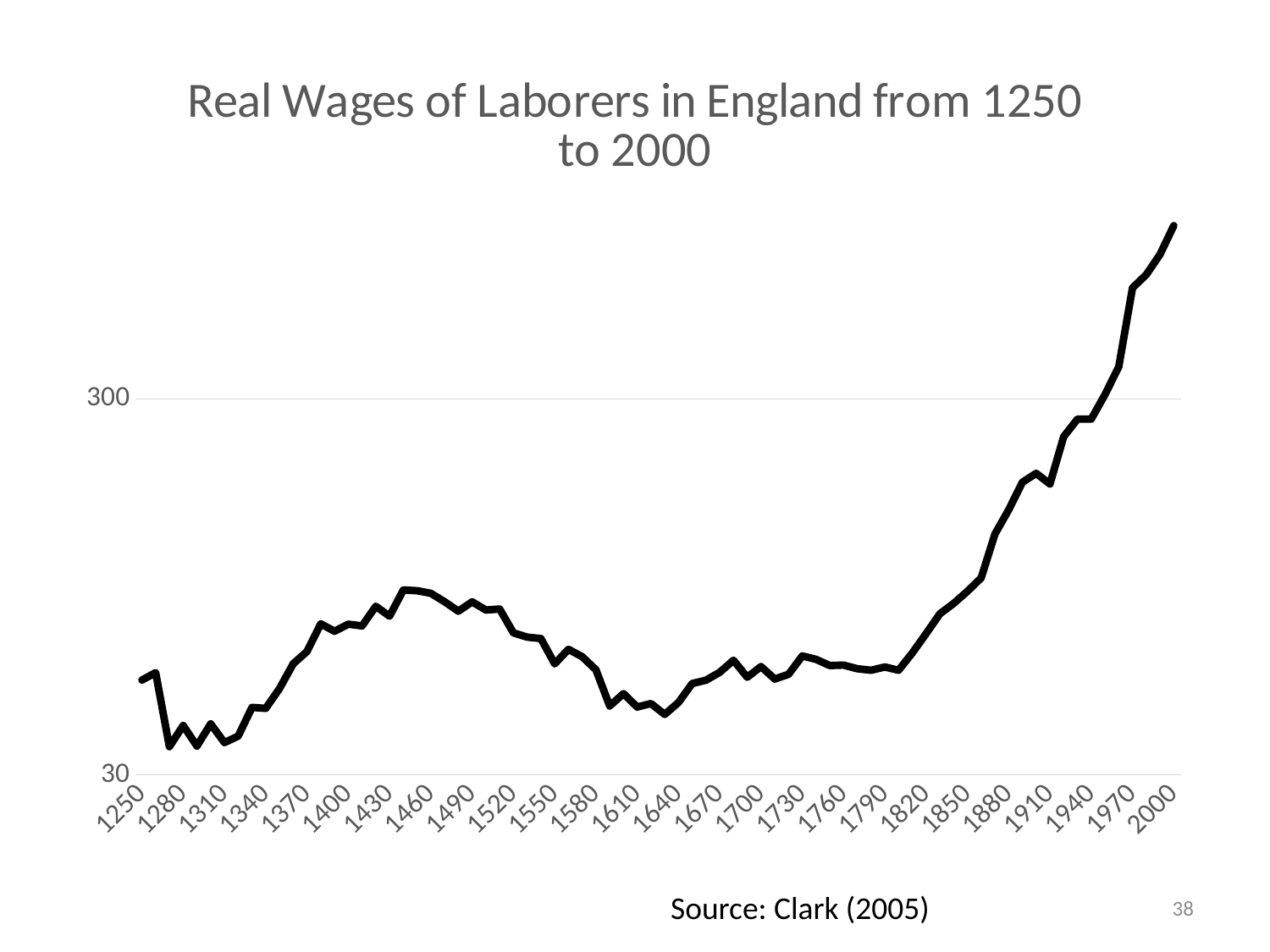
Is the value for 1970 greater or less than 300? greater What kind of chart is shown on the slide? line chart Do real wages rise or fall between 1820 and 2000? rise How many year labels are shown on the x axis? 26 Is the value for 1910 greater or less than 300? less Which year has the higher real wage, 1250 or 2000? 2000 In which year shown on the x axis is the real wage highest? 2000 Which year has the higher real wage, 1460 or 1610? 1460 Is the value for 1460 greater or less than 300? less What source is cited for the chart? Clark (2005) What is the title of the chart? Real Wages of Laborers in England from 1250 to 2000